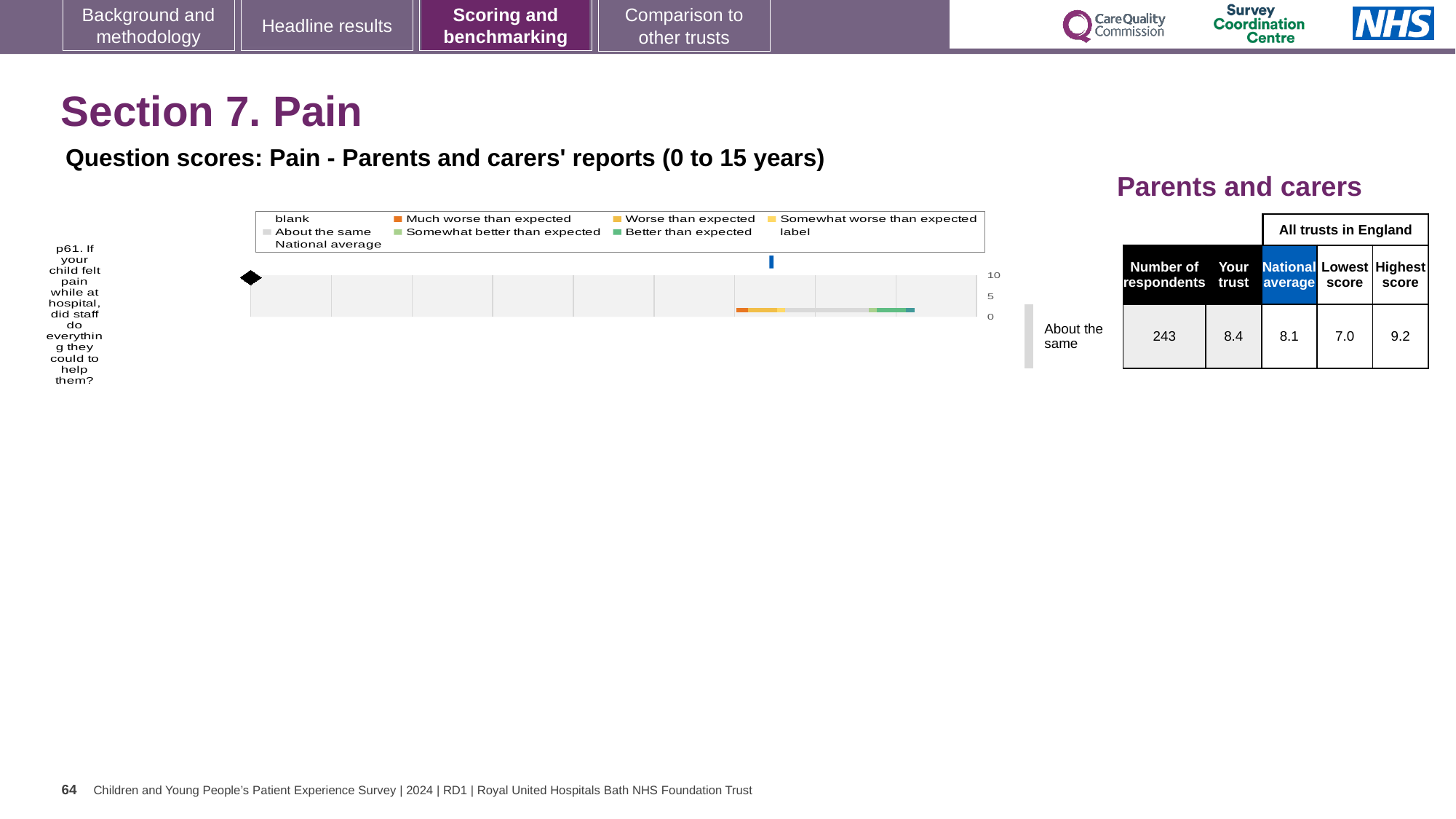
How many survey questions are plotted in the chart? 1 What kind of chart is shown on the slide? bar chart In the table beside the chart, what is the National average score? 8.1 How many entries does the chart legend list? 9 In the table beside the chart, what is the Highest score across all trusts in England? 9.2 In the table beside the chart, what is the Lowest score across all trusts in England? 7.0 In the table beside the chart, how many respondents are listed? 243 What is the highest tick value shown on the chart's score axis? 10 In the table beside the chart, what is the 'Your trust' score for the 'About the same' row? 8.4 In the table beside the chart, what is the difference between the Highest score and the Lowest score? 2.2 In the table beside the chart, which is larger: the Your trust score or the National average score? Your trust